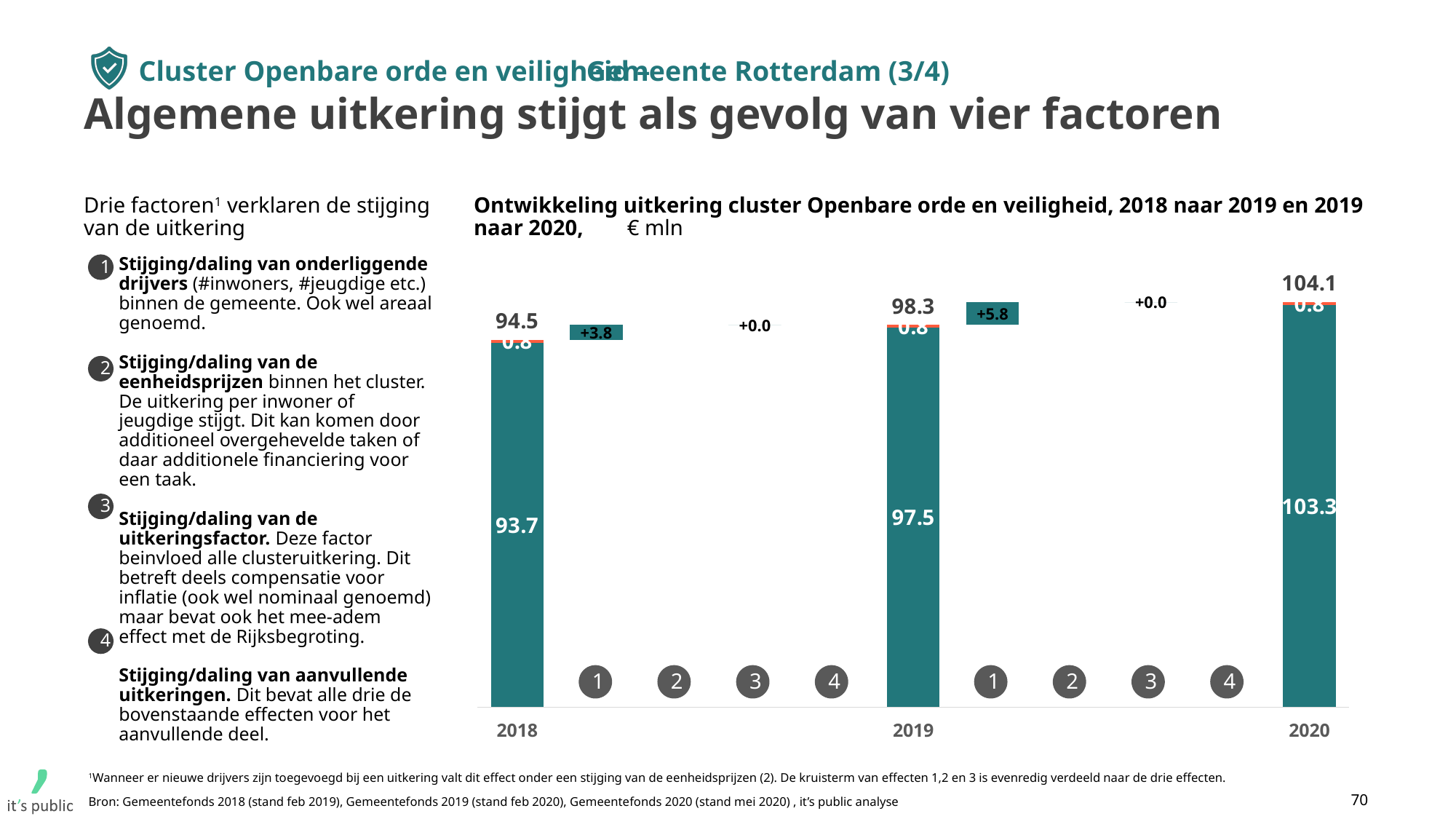
What is the value of the small top segment of the 2018 bar? 0.8 What is the total value of the bar for 2020? 104.1 What is the total value of the bar for 2019? 98.3 What is the total value of the bar for 2018? 94.5 Which year has the lowest total bar? 2018 What is the value of the large lower segment of the 2020 bar? 103.3 What is the value of the large lower segment of the 2019 bar? 97.5 What is the difference between the 2020 total (104.1) and the 2018 total (94.5)? 9.6 Do the yearly totals rise or fall from 2018 to 2020? rise Which year has the highest total bar? 2020 What is the change shown for factor 1 between 2019 and 2020? +5.8 What is the change shown for factor 1 between 2018 and 2019? +3.8